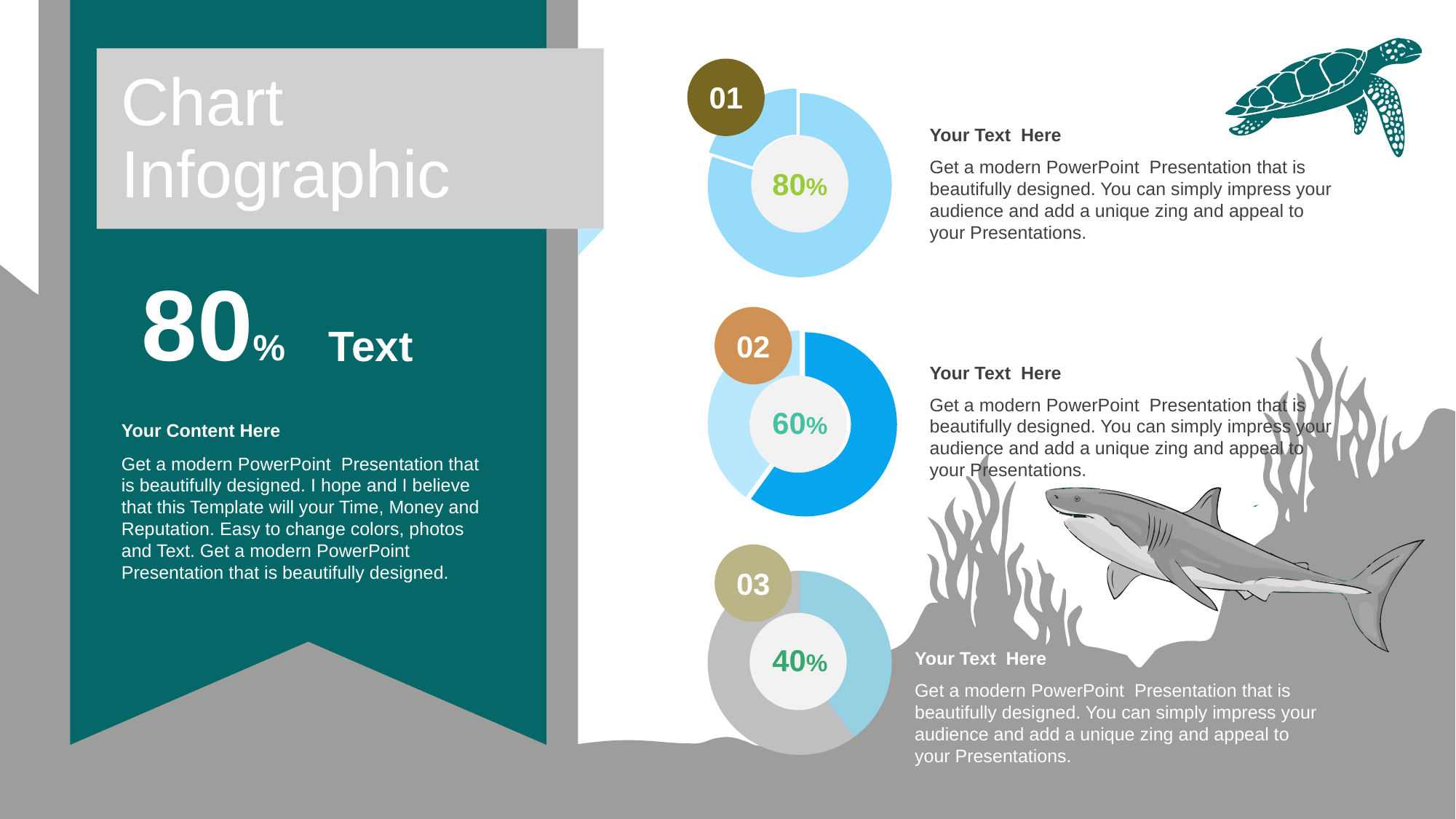
What type of chart is used for the three charts on the right side of the slide? Donut chart Do the percentages in the donut charts increase or decrease going from chart 01 at the top to chart 03 at the bottom? Decrease What is the difference between the percentage in chart 01 and the percentage in chart 03? 40% What percentage is shown in the centre of the donut chart labelled 02? 60% Which of the three donut charts (01, 02 or 03) shows the lowest percentage? 03 Which shows a larger percentage, the donut chart labelled 02 or the donut chart labelled 03? 02 What is the title of the slide? Chart Infographic Which of the three donut charts (01, 02 or 03) shows the highest percentage? 01 How many donut charts are on the slide? 3 What percentage is shown in the centre of the donut chart labelled 03? 40% What is the difference between the percentage in chart 02 and the percentage in chart 03? 20% What percentage is shown in the centre of the donut chart labelled 01? 80%